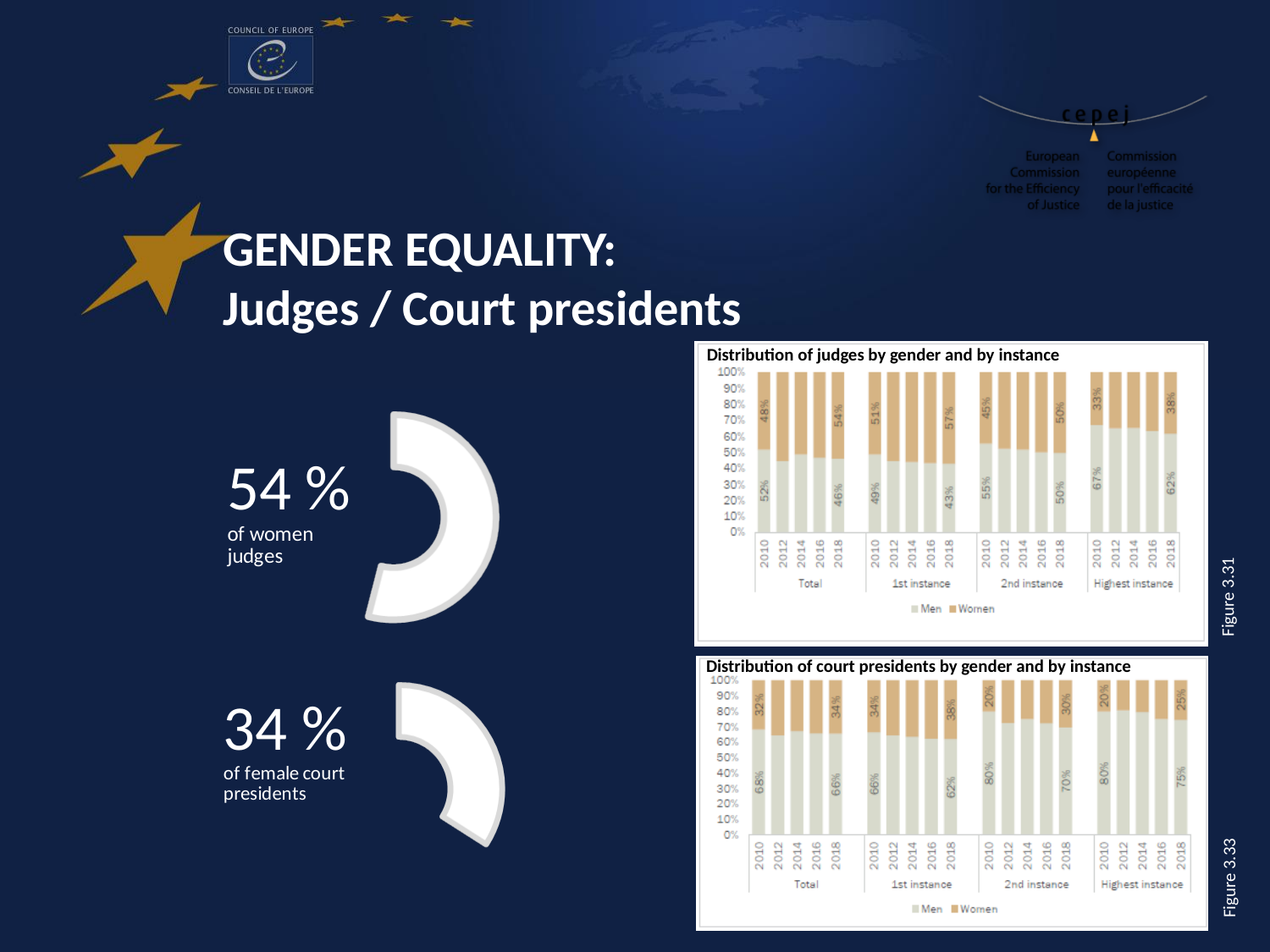
In the chart 'Distribution of court presidents by gender and by instance', what percentage of court presidents in total were women in 2018? 34% In the chart 'Distribution of judges by gender and by instance', does the share of women judges in total rise or fall from 2010 to 2018? Rise In the chart 'Distribution of judges by gender and by instance', which instance had the lowest share of women judges in 2018? Highest instance In the chart 'Distribution of judges by gender and by instance', was the share of women among 1st instance judges in 2018 larger or smaller than among highest instance judges in 2018? Larger What type of chart is 'Distribution of judges by gender and by instance'? Stacked bar chart In the chart 'Distribution of judges by gender and by instance', by how many percentage points did the share of women judges in total change between 2010 and 2018? 6 percentage points How many series does the legend of the chart 'Distribution of court presidents by gender and by instance' list? 2 In the chart 'Distribution of judges by gender and by instance', what percentage of 1st instance judges were women in 2018? 57% In the chart 'Distribution of judges by gender and by instance', what percentage of highest instance judges were men in 2010? 67% In the chart 'Distribution of judges by gender and by instance', what percentage of judges in total were women in 2018? 54% In the chart 'Distribution of court presidents by gender and by instance', what is the difference between the share of men among 2nd instance court presidents in 2010 and in 2018? 10 percentage points In the chart 'Distribution of court presidents by gender and by instance', what percentage of 2nd instance court presidents were men in 2010? 80%